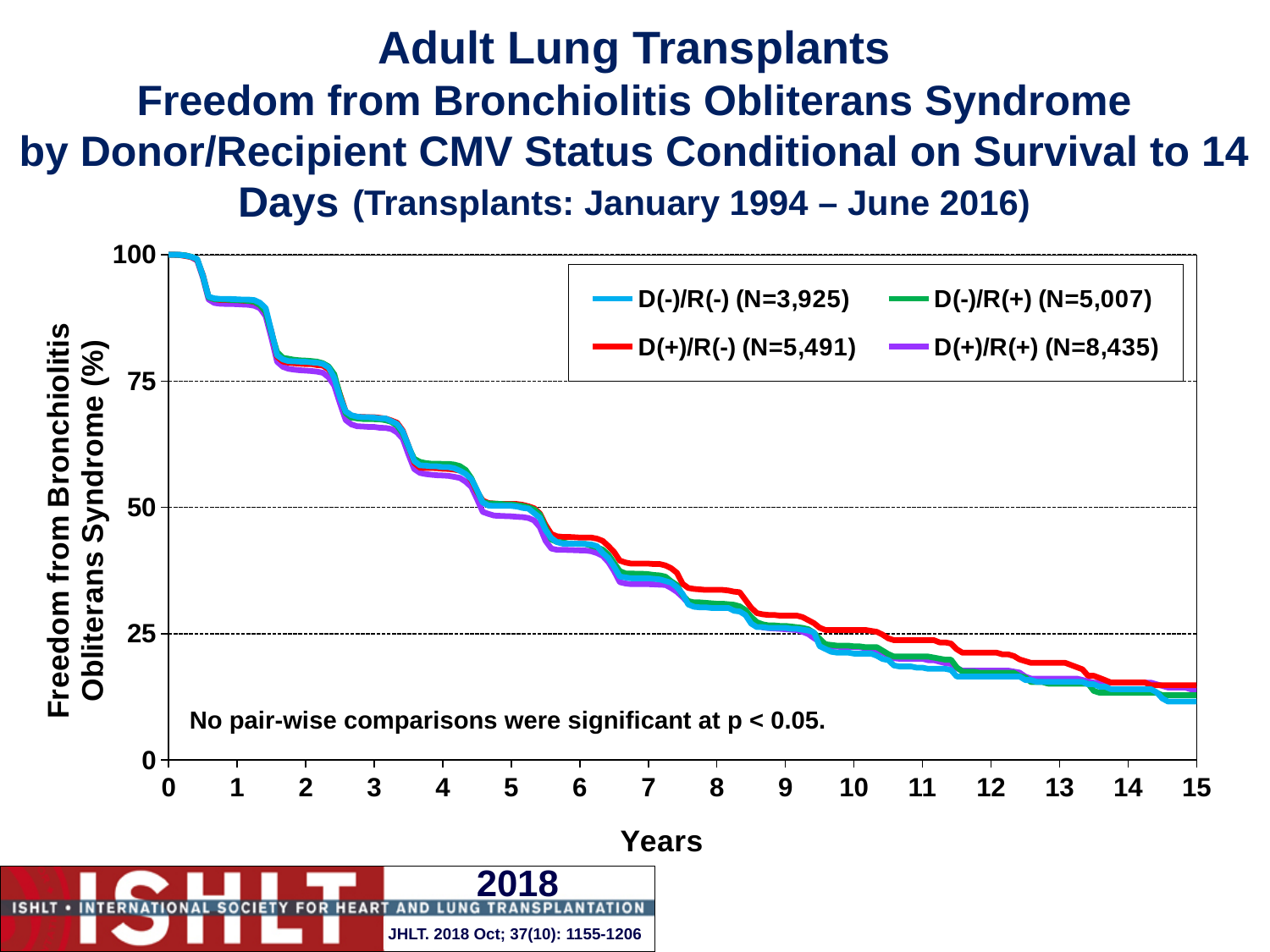
Do the curves rise or fall as the number of years increases? fall What is the value of freedom from bronchiolitis obliterans syndrome for all groups at year 0? 100 Is the value for D(-)/R(+) at year 7 greater or less than 50? less How many series does the legend list? 4 Is the value for D(+)/R(+) at year 1 greater or less than 75? greater What is the maximum value shown on the y axis? 100 What is the N for the D(+)/R(+) group shown in the legend? 8,435 What kind of chart is shown on the slide? line chart Which series has the highest freedom from bronchiolitis obliterans syndrome at year 12? D(+)/R(-) What is the label of the x axis? Years Is the value for D(+)/R(-) at year 3 greater or less than 50? greater